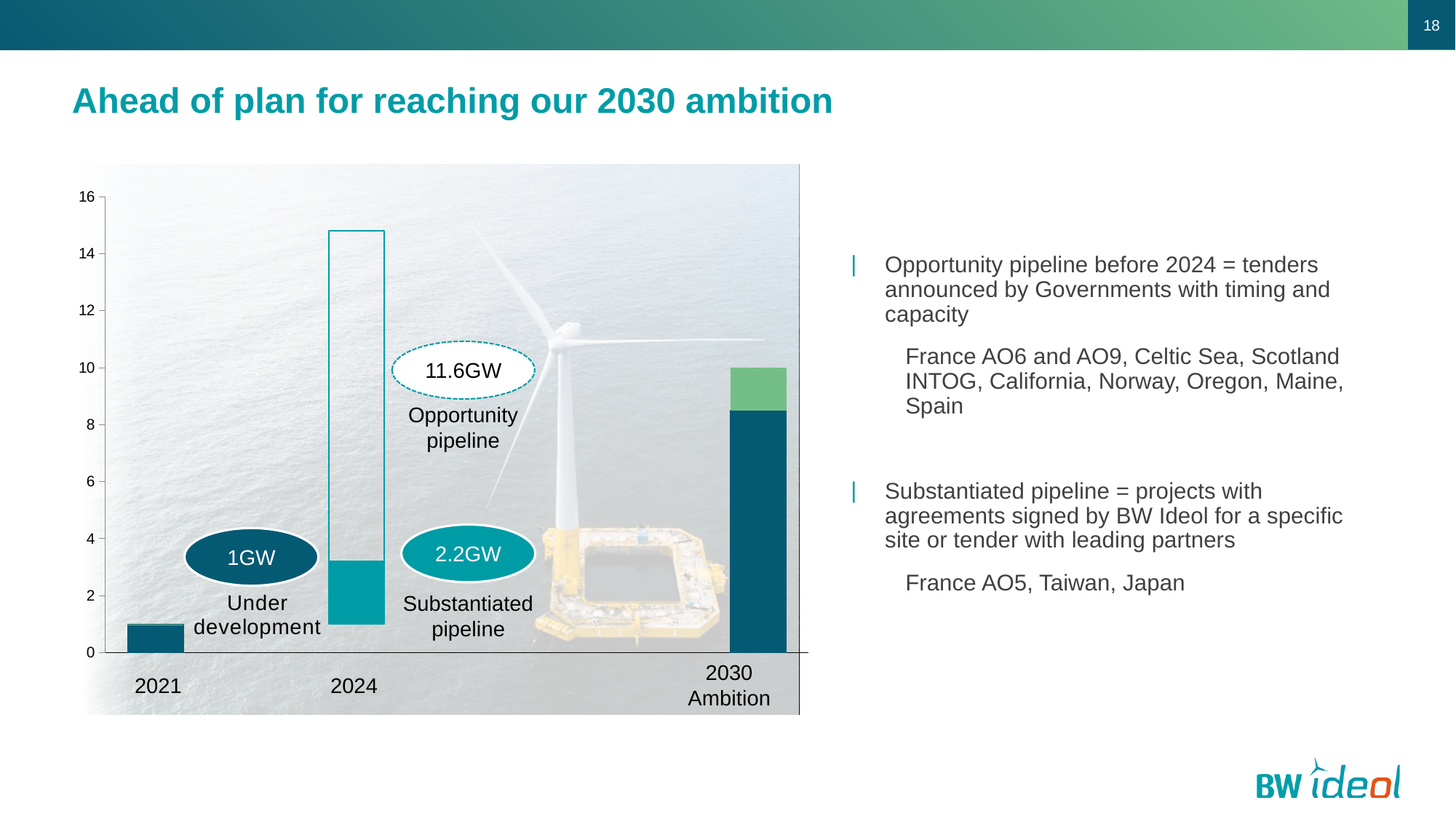
Is the value for 2021 greater or less than 2? less Which category has the tallest bar in the chart? 2024 What kind of chart is shown on the slide? bar chart What value is labelled for the opportunity pipeline in the chart? 11.6GW What is the difference between the opportunity pipeline and the substantiated pipeline values? 9.4GW How many categories are shown on the x axis of the chart? 3 What value is labelled as under development in the chart? 1GW What is the highest tick value shown on the y axis of the chart? 16 What value is labelled for the substantiated pipeline in the chart? 2.2GW Which bar is taller, 2024 or 2030 Ambition? 2024 Is the total height of the 2030 Ambition bar greater or less than 8? greater Which category has the shortest bar in the chart? 2021